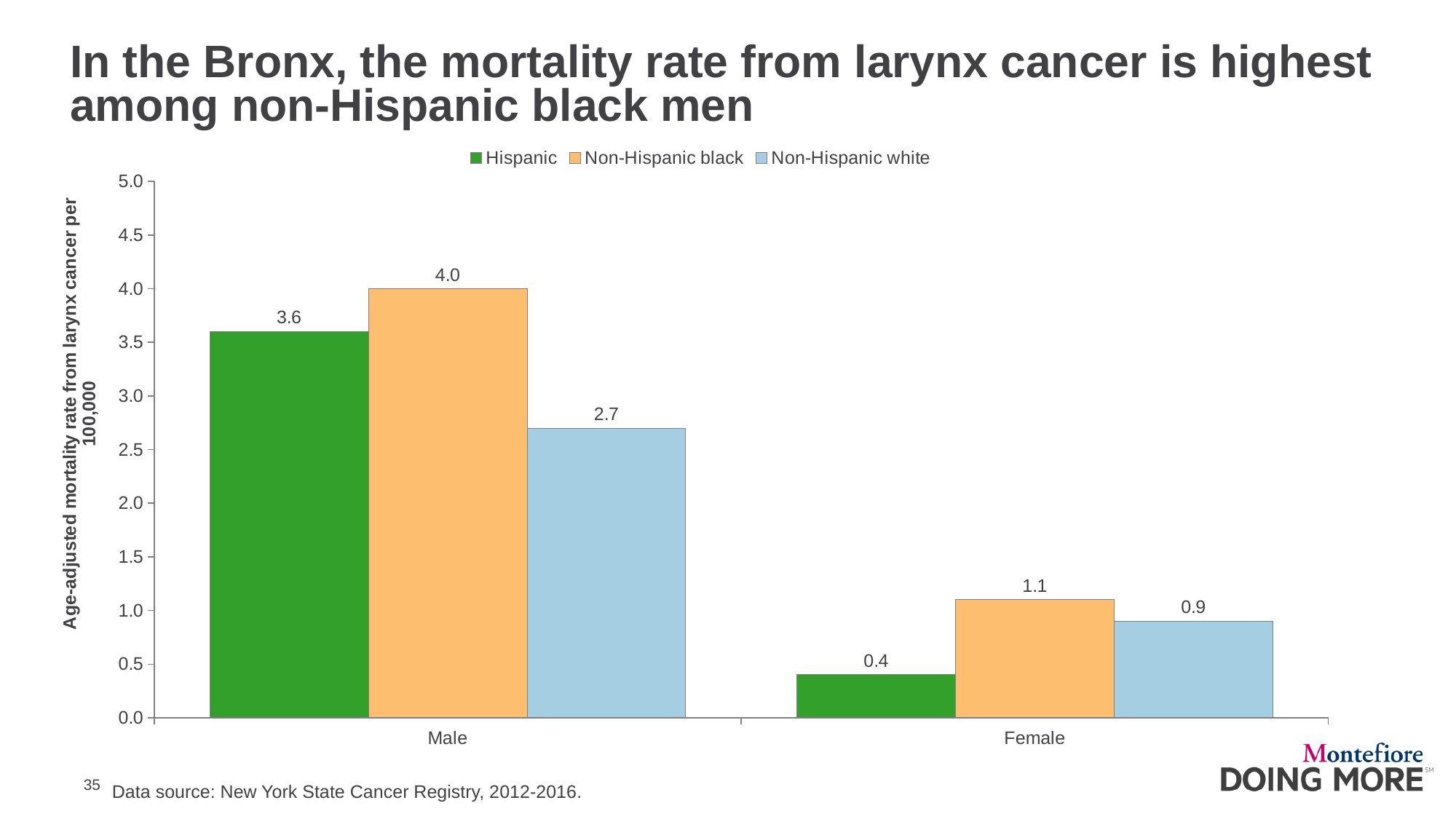
Which is larger, the mortality rate for non-Hispanic black females or non-Hispanic white females? Non-Hispanic black females How many series does the legend list? 3 Is the mortality rate for Hispanic males greater or less than 3.0? greater Which group has the lowest mortality rate among females? Hispanic What is the age-adjusted mortality rate from larynx cancer for Hispanic females? 0.4 What is the age-adjusted mortality rate from larynx cancer for non-Hispanic black males? 4.0 What kind of chart is shown on the slide? Bar chart Which group has the highest mortality rate among males? Non-Hispanic black What is the age-adjusted mortality rate from larynx cancer for non-Hispanic white males? 2.7 What is the difference between the mortality rates for non-Hispanic black males and non-Hispanic white males? 1.3 What is the difference between the mortality rates for Hispanic males and Hispanic females? 3.2 What colour represents the Hispanic series in the chart? Green